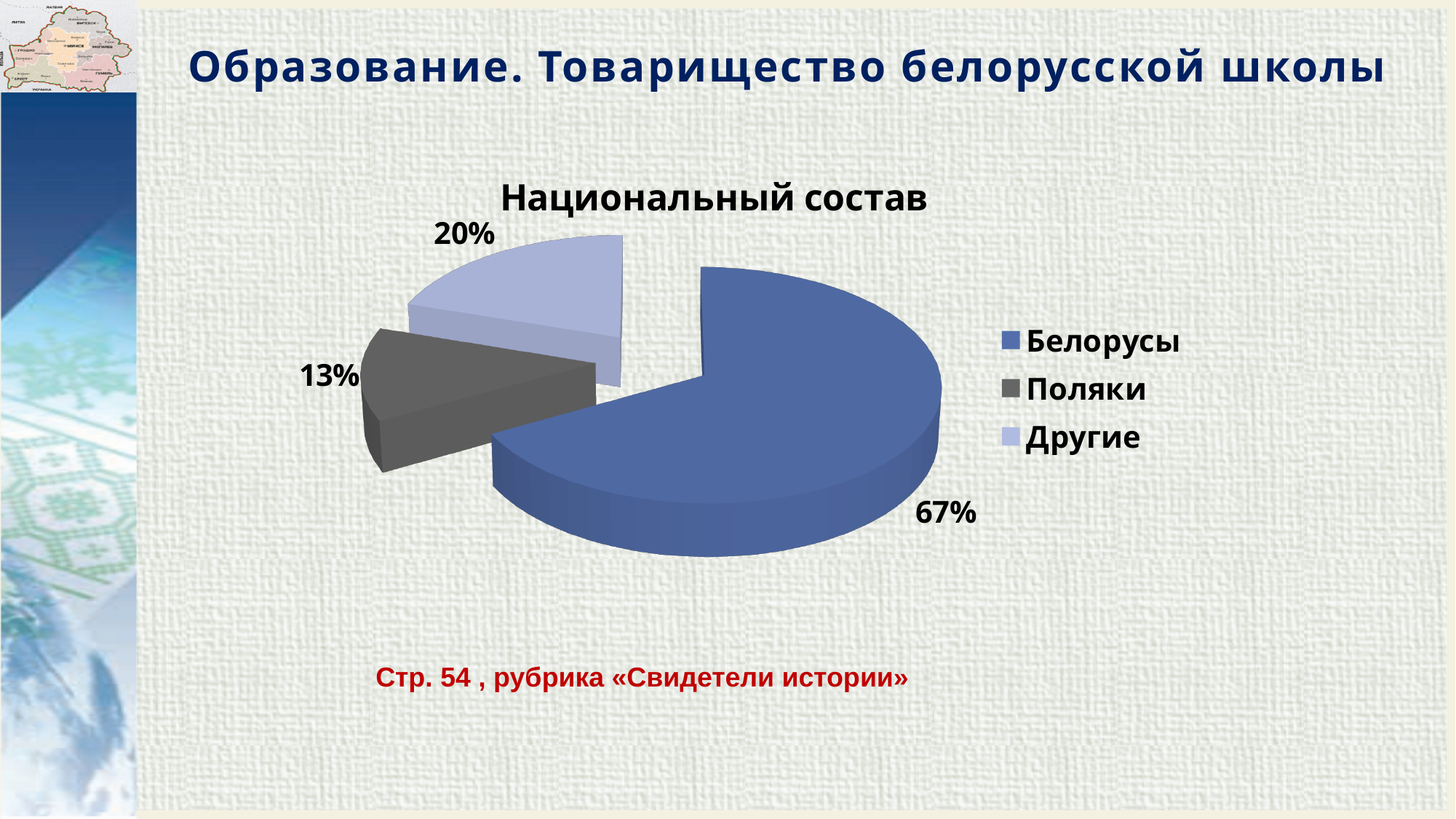
What colour is the slice for Поляки? dark grey Which is larger, the share for Поляки or the share for Другие? Другие How many categories does the pie chart show? 3 What type of chart is shown on the slide? pie chart What is the difference in percentage points between Белорусы and Другие? 47 Which category has the largest slice of the pie? Белорусы What share of the pie does Поляки have? 13% What is the title of the chart? Национальный состав What share of the pie does Белорусы have? 67% What is the difference in percentage points between Другие and Поляки? 7 What share of the pie does Другие have? 20% Which category has the smallest slice of the pie? Поляки